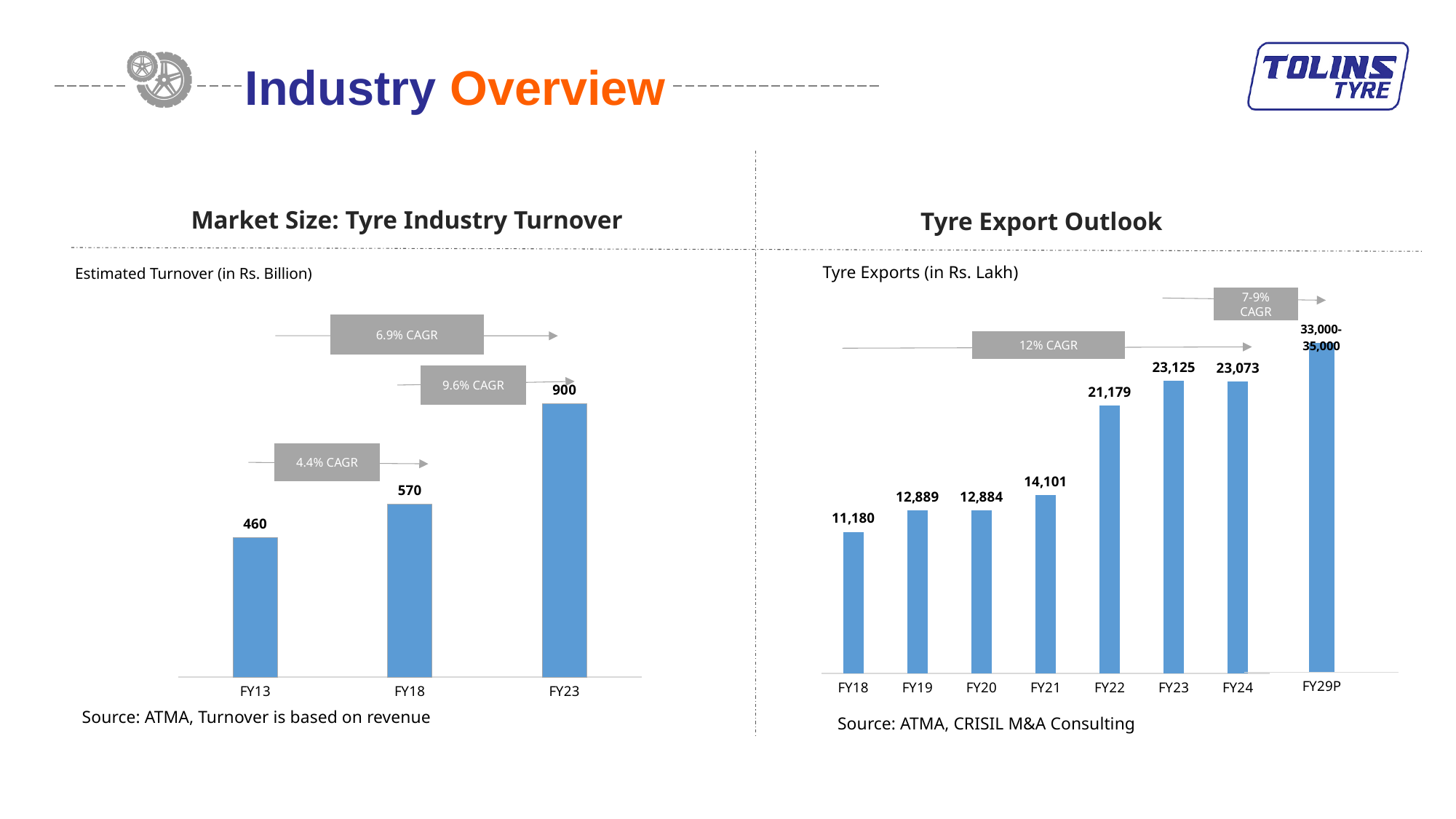
In the Market Size: Tyre Industry Turnover chart, what is the estimated turnover for FY18? 570 In the Tyre Export Outlook chart, which fiscal year has the lowest value? FY18 In the Tyre Export Outlook chart, what unit are the tyre exports shown in? Rs. Lakh In the Tyre Export Outlook chart, what is the difference between the FY23 and FY24 values? 52 In the Tyre Export Outlook chart, what is the value for FY22? 21,179 What type of chart is the Tyre Export Outlook chart? Bar chart In the Market Size: Tyre Industry Turnover chart, what is the estimated turnover for FY23? 900 In the Market Size: Tyre Industry Turnover chart, what CAGR is shown between FY13 and FY23? 6.9% CAGR In the Market Size: Tyre Industry Turnover chart, what is the difference between the FY23 and FY13 values? 440 In the Tyre Export Outlook chart, how many fiscal years are plotted? 8 In the Market Size: Tyre Industry Turnover chart, how many fiscal years are plotted? 3 In the Tyre Export Outlook chart, what is the value for FY29P? 33,000-35,000